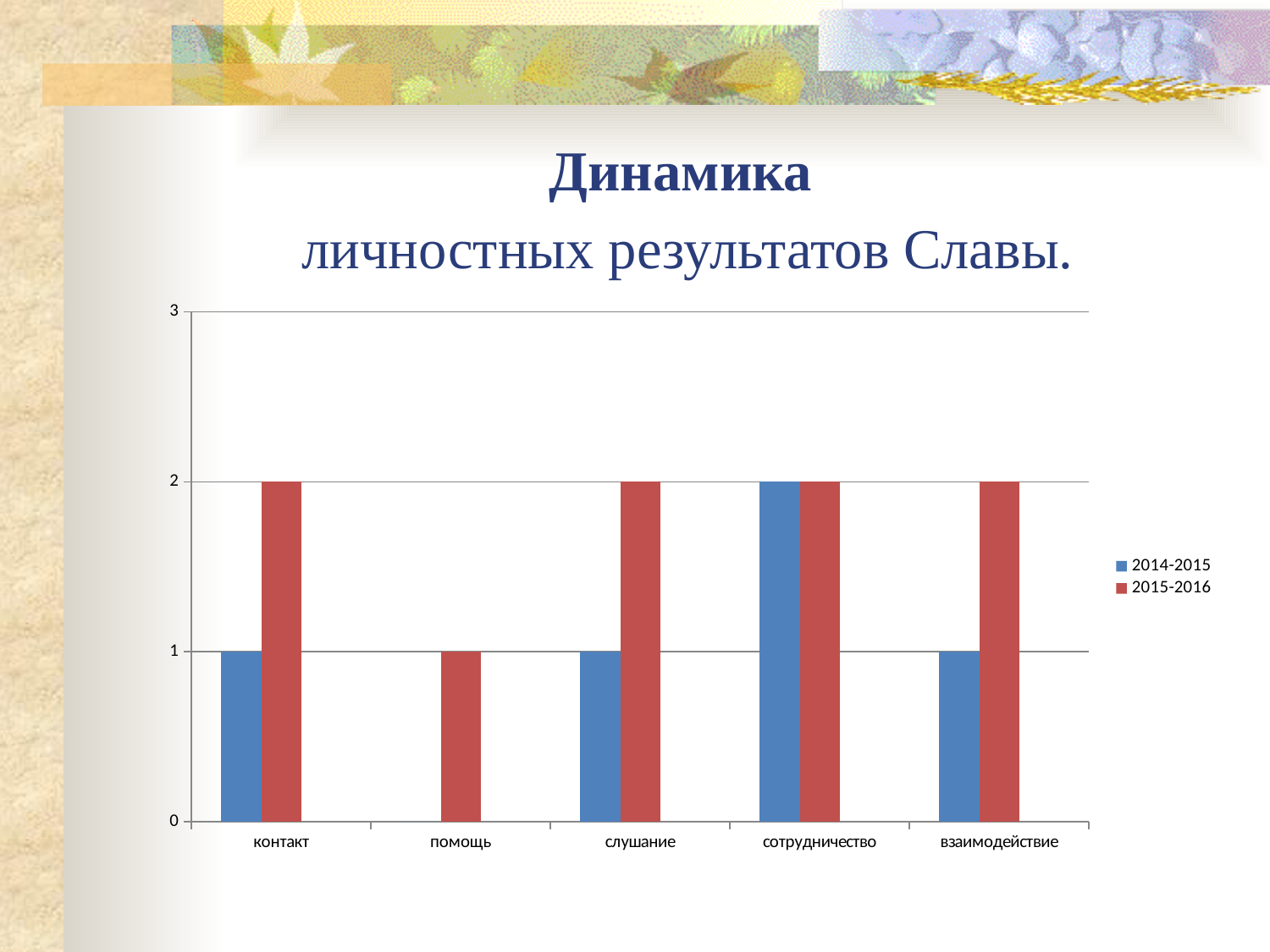
What is the value for помощь in the 2015-2016 series? 1 What is the value for контакт in the 2014-2015 series? 1 What is the value for взаимодействие in the 2015-2016 series? 2 What is the difference between the 2015-2016 and 2014-2015 values for слушание? 1 Which category has the highest value in the 2014-2015 series? сотрудничество Which series is shown in red in the legend? 2015-2016 How many categories are shown on the x axis? 5 What is the value for сотрудничество in the 2014-2015 series? 2 What is the value for контакт in the 2015-2016 series? 2 How many series does the legend list? 2 What kind of chart is shown on the slide? bar chart Which category has the lowest value in the 2015-2016 series? помощь